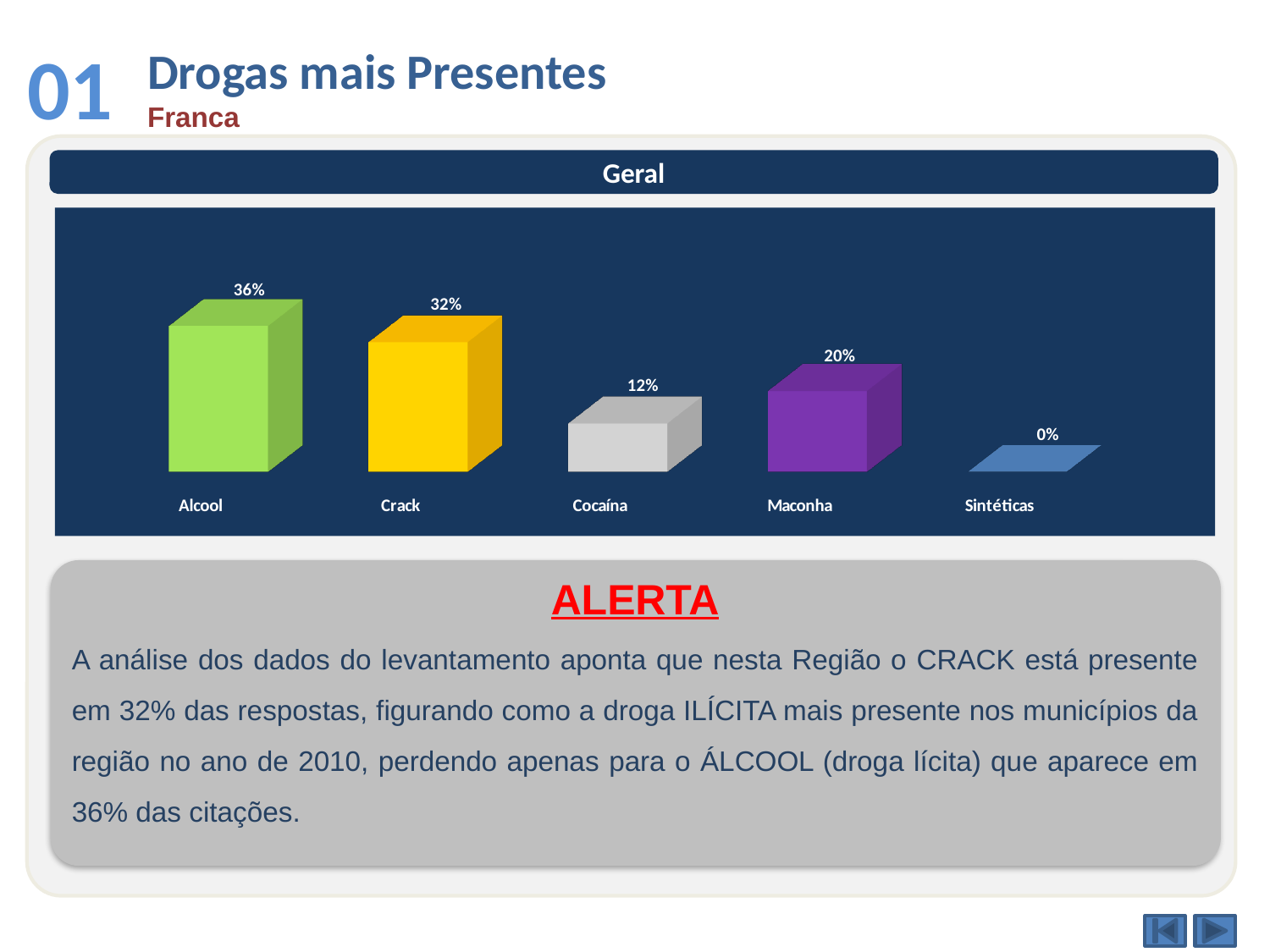
What is the value for Cocaína in the chart? 12% What is the value for Sintéticas in the chart? 0% What is the value for Maconha in the chart? 20% What kind of chart is shown on the slide? Bar chart Which category has the highest value in the chart? Alcool What is the difference between the values for Maconha and Cocaína? 8% What is the difference between the values for Alcool and Crack? 4% How many categories are shown in the chart? 5 What is the value for Crack in the chart? 32% What is the value for Alcool in the chart? 36% Which category has the lowest value in the chart? Sintéticas Which is larger, the value for Maconha or the value for Cocaína? Maconha